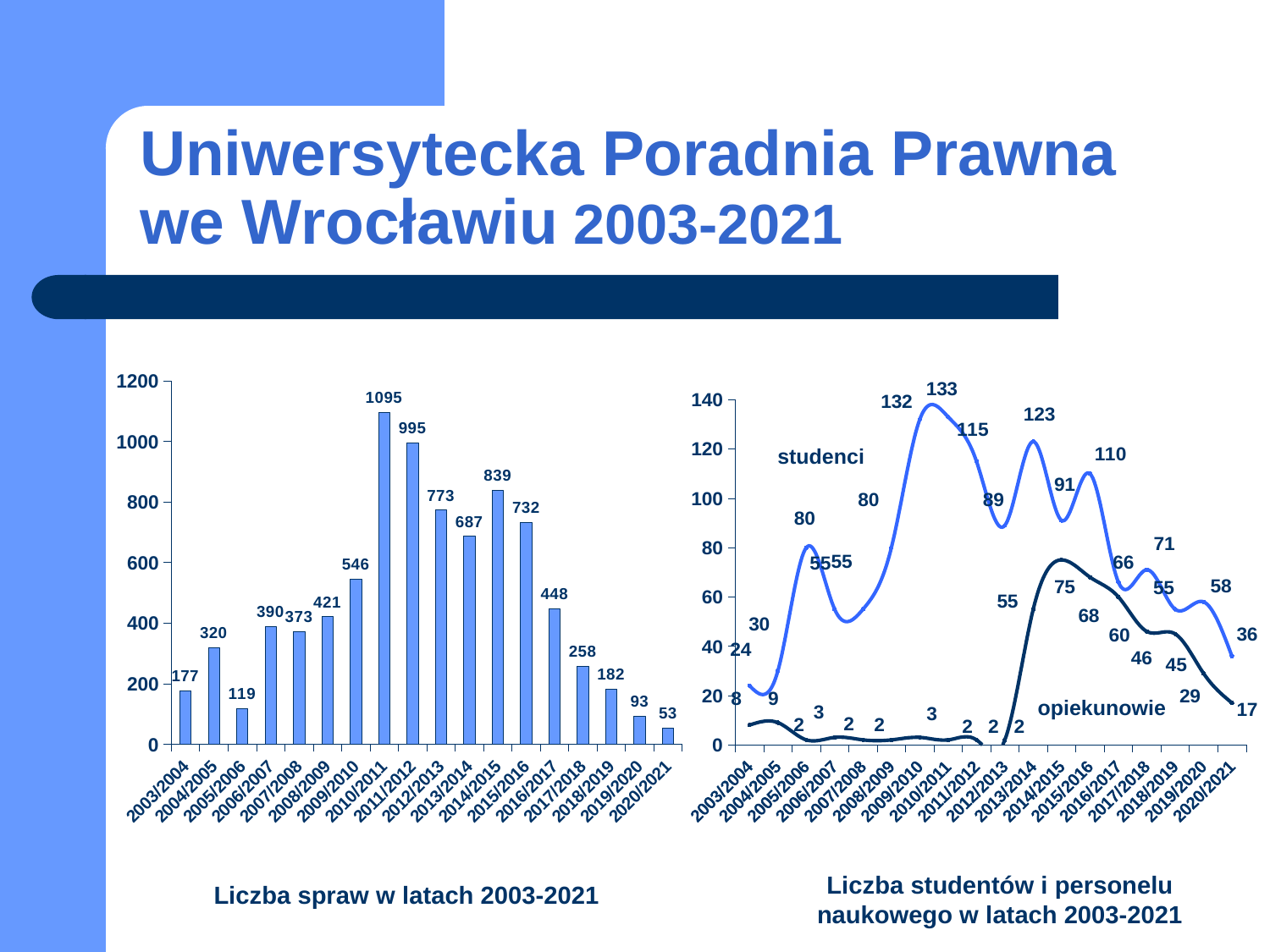
In the right chart (Liczba studentów i personelu naukowego w latach 2003-2021), what is the value of the opiekunowie series for 2020/2021? 17 In the right chart (Liczba studentów i personelu naukowego w latach 2003-2021), what is the highest value of the studenci series? 133 In the left chart (Liczba spraw w latach 2003-2021), what is the value for 2020/2021? 53 In the left chart (Liczba spraw w latach 2003-2021), how many years are shown on the x axis? 18 In the left chart (Liczba spraw w latach 2003-2021), which year has the lowest value? 2020/2021 In the left chart (Liczba spraw w latach 2003-2021), what is the value for 2010/2011? 1095 How many series are plotted in the right chart (Liczba studentów i personelu naukowego w latach 2003-2021)? 2 In the right chart (Liczba studentów i personelu naukowego w latach 2003-2021), what are the names of the two series? studenci and opiekunowie In the left chart (Liczba spraw w latach 2003-2021), which is larger, the value for 2013/2014 or 2014/2015? 2014/2015 In the left chart (Liczba spraw w latach 2003-2021), what is the difference between the values for 2010/2011 and 2011/2012? 100 What kind of chart is the left chart (Liczba spraw w latach 2003-2021)? bar chart In the left chart (Liczba spraw w latach 2003-2021), which year has the highest value? 2010/2011